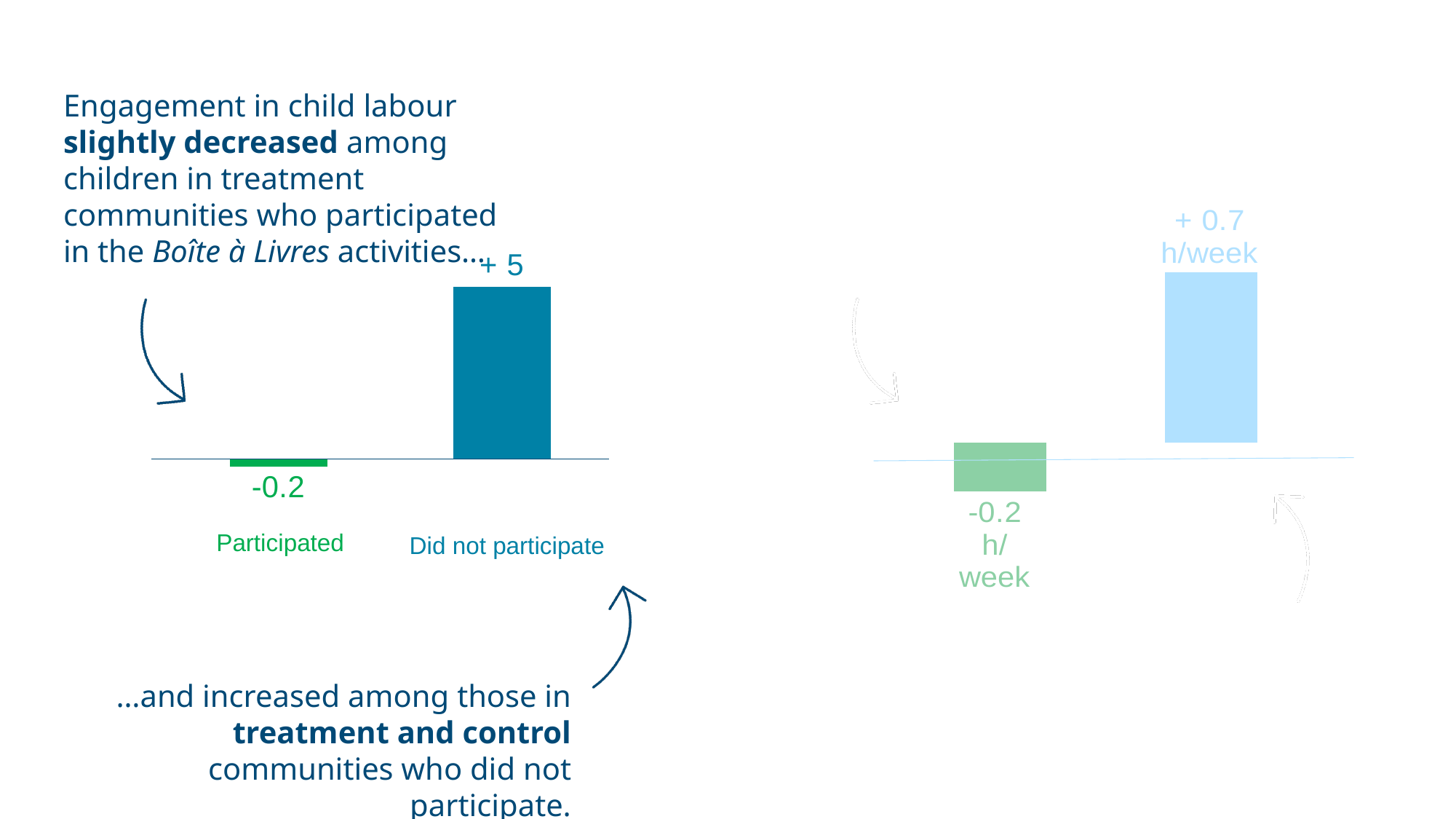
In the right chart, what is the value labelled on the left bar? -0.2 h/week In the left chart, what is the difference between the values for Did not participate and Participated? 5.2 In the left chart, what is the value for Did not participate? + 5 What kind of chart is the left chart? bar chart In the left chart, is the value for Participated or Did not participate larger? Did not participate In the left chart, what colour is the bar for Participated? green How many bars are shown in the right chart? 2 In the left chart, what is the value for Participated? -0.2 In the left chart, which category has the highest value? Did not participate How many categories are shown in the left chart? 2 In the right chart, what is the value labelled on the right bar? + 0.7 h/week In the left chart, which category has the lowest value? Participated